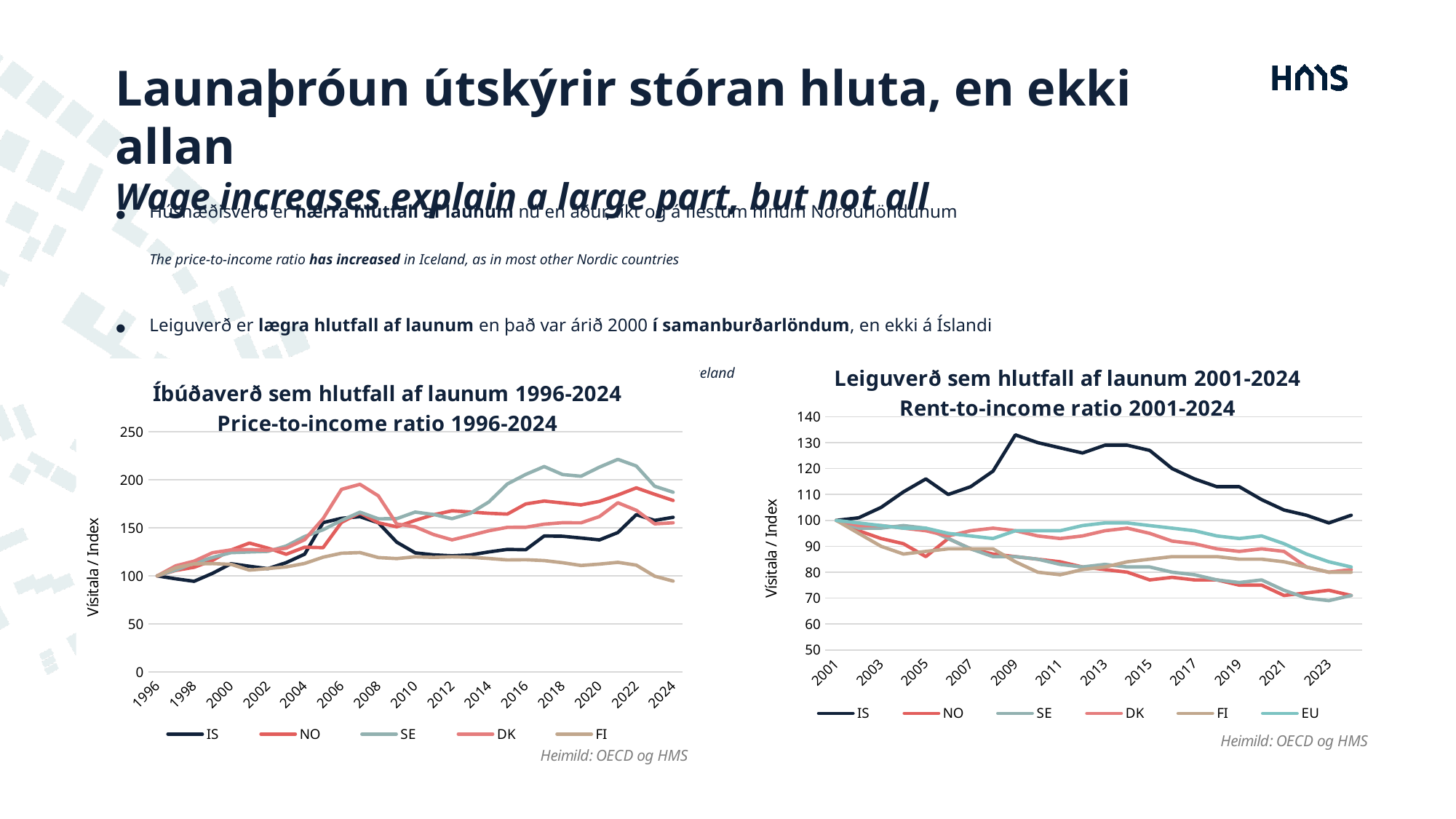
In the left chart, 'Price-to-income ratio 1996-2024', which series has the lowest value in 2024? FI In the left chart, 'Price-to-income ratio 1996-2024', which series has the highest value in 2022? SE In the right chart, 'Rent-to-income ratio 2001-2024', is the value for IS in 2009 greater or less than 120? greater In the left chart, 'Price-to-income ratio 1996-2024', is the value for FI in 2024 greater or less than 100? less In the right chart, 'Rent-to-income ratio 2001-2024', is the value for FI in 2024 greater or less than 90? less In the right chart, 'Rent-to-income ratio 2001-2024', does the IS series rise or fall between 2009 and 2023? fall In the right chart, 'Rent-to-income ratio 2001-2024', which series has the highest value in 2009? IS What kind of chart is the left chart, 'Price-to-income ratio 1996-2024'? line chart How many series does the legend of the left chart, 'Price-to-income ratio 1996-2024', list? 5 Which series appears in the legend of the right chart, 'Rent-to-income ratio 2001-2024', but not in the legend of the left chart? EU How many series does the legend of the right chart, 'Rent-to-income ratio 2001-2024', list? 6